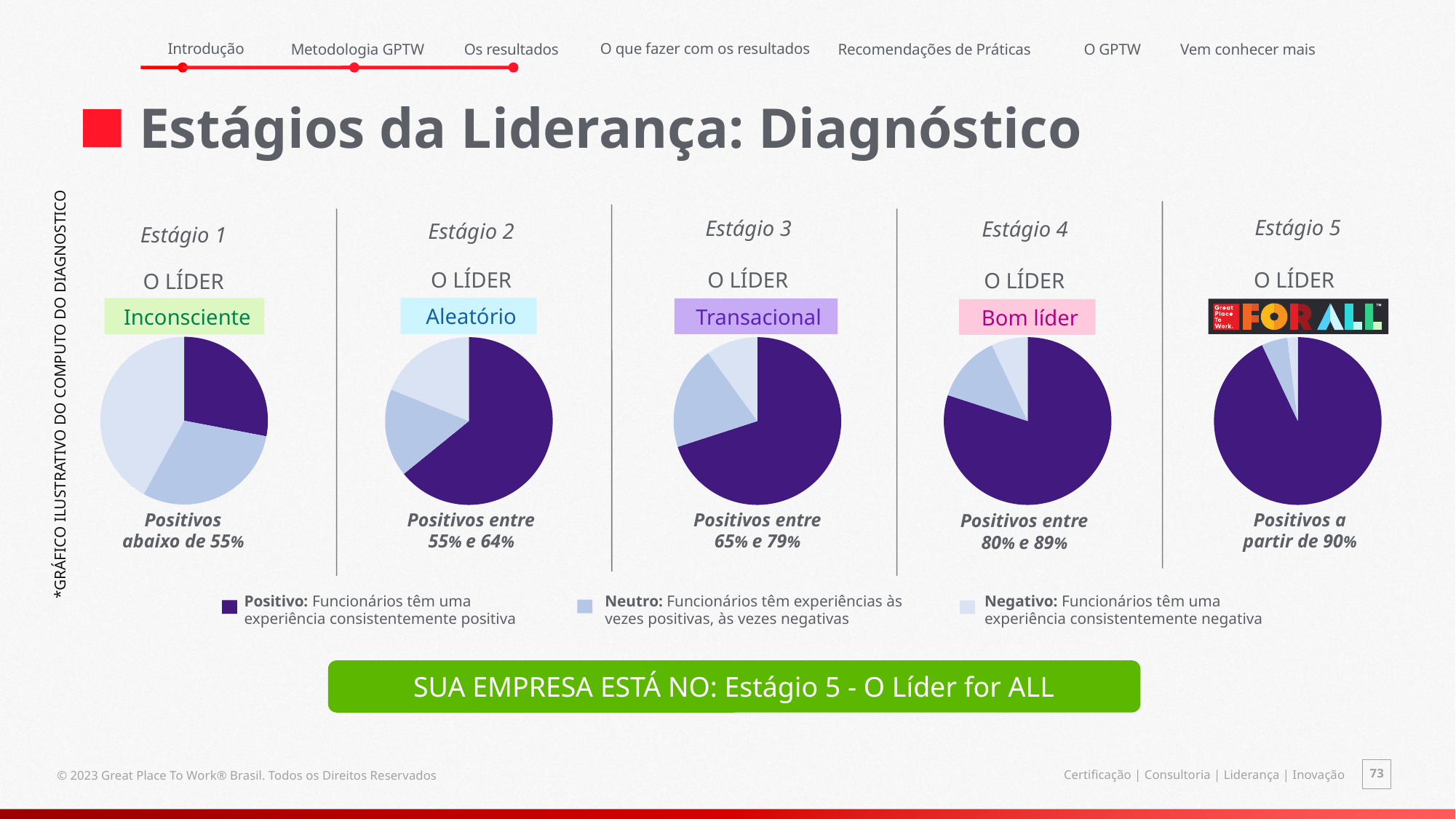
How many pie charts are shown on the slide? 5 Which pie chart has the larger Positivo slice, Estágio 1 or Estágio 5? Estágio 5 Does the Positivo share of the pie charts rise or fall from Estágio 1 to Estágio 5? Rise In the Estágio 2 pie chart, which category has the largest slice? Positivo How many categories does the legend at the bottom of the slide list? 3 In the Estágio 3 pie chart, which category has the smallest slice? Negativo What kind of charts are shown on the slide? Pie charts What are the three legend entries shown below the pie charts? Positivo, Neutro, Negativo In the Estágio 5 pie chart, which category has the largest slice? Positivo What range of positive responses is written under the Estágio 3 pie chart? Positivos entre 65% e 79% In the Estágio 3 pie chart, which category has the largest slice? Positivo